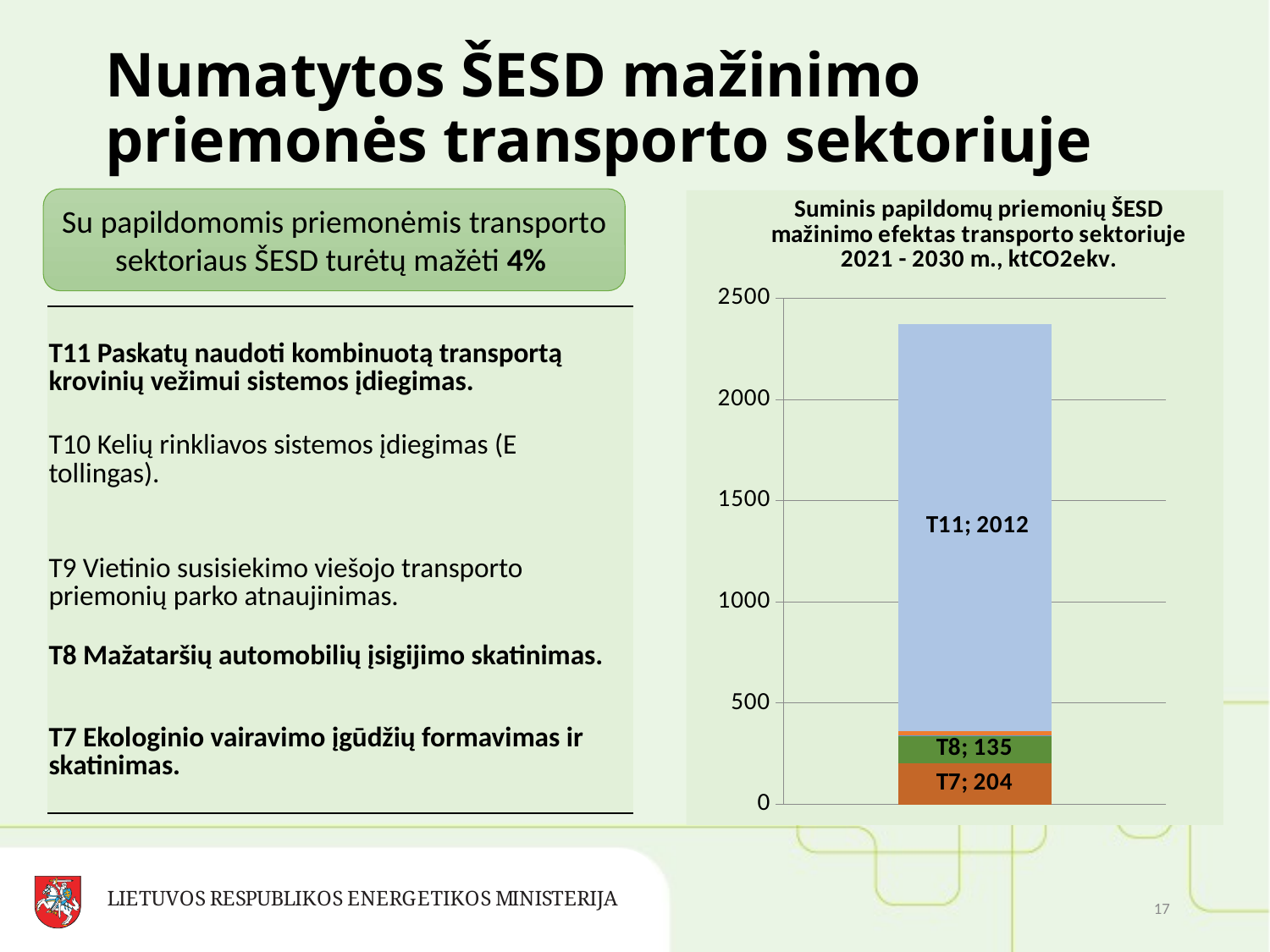
What unit is given in the chart title? ktCO2ekv. What is the highest value shown on the chart's vertical axis? 2500 What is the value of the T11 segment in the stacked bar? 2012 What kind of chart is shown on the slide? Stacked bar chart What is the difference between the T11 and T7 segment values? 1808 What is the value of the T7 segment in the stacked bar? 204 Which labelled segment of the stacked bar has the largest value? T11 What is the difference between the T7 and T8 segment values? 69 Which segment has the larger value, T7 or T8? T7 Which labelled segment of the stacked bar has the smallest value? T8 What is the value of the T8 segment in the stacked bar? 135 Is the total height of the stacked bar greater or less than 2000? greater